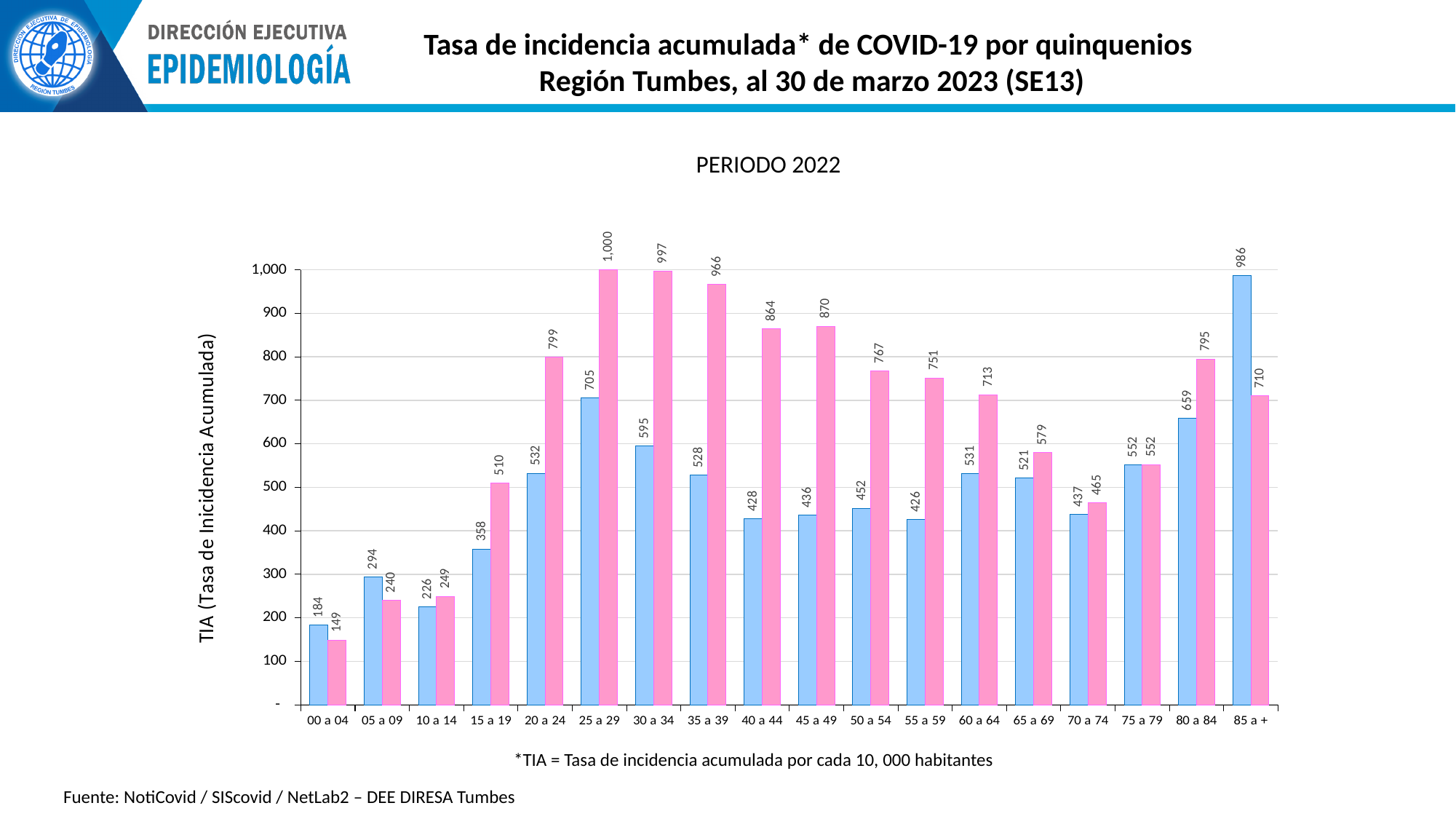
What is the title shown above the chart? PERIODO 2022 Which age group has the lowest pink bar? 00 a 04 What is the value of the blue bar for the 25 a 29 age group? 705 Which age group has the highest blue bar? 85 a + What is the value of the blue bar for the 15 a 19 age group? 358 For the 20 a 24 age group, how much larger is the pink bar than the blue bar? 267 Which age group has the highest pink bar? 25 a 29 For the 30 a 34 age group, which bar is larger, the blue or the pink? pink What kind of chart is shown on the slide? bar chart How many age groups are shown on the x axis? 18 For the 85 a + age group, how much larger is the blue bar than the pink bar? 276 What is the value of the pink bar for the 85 a + age group? 710